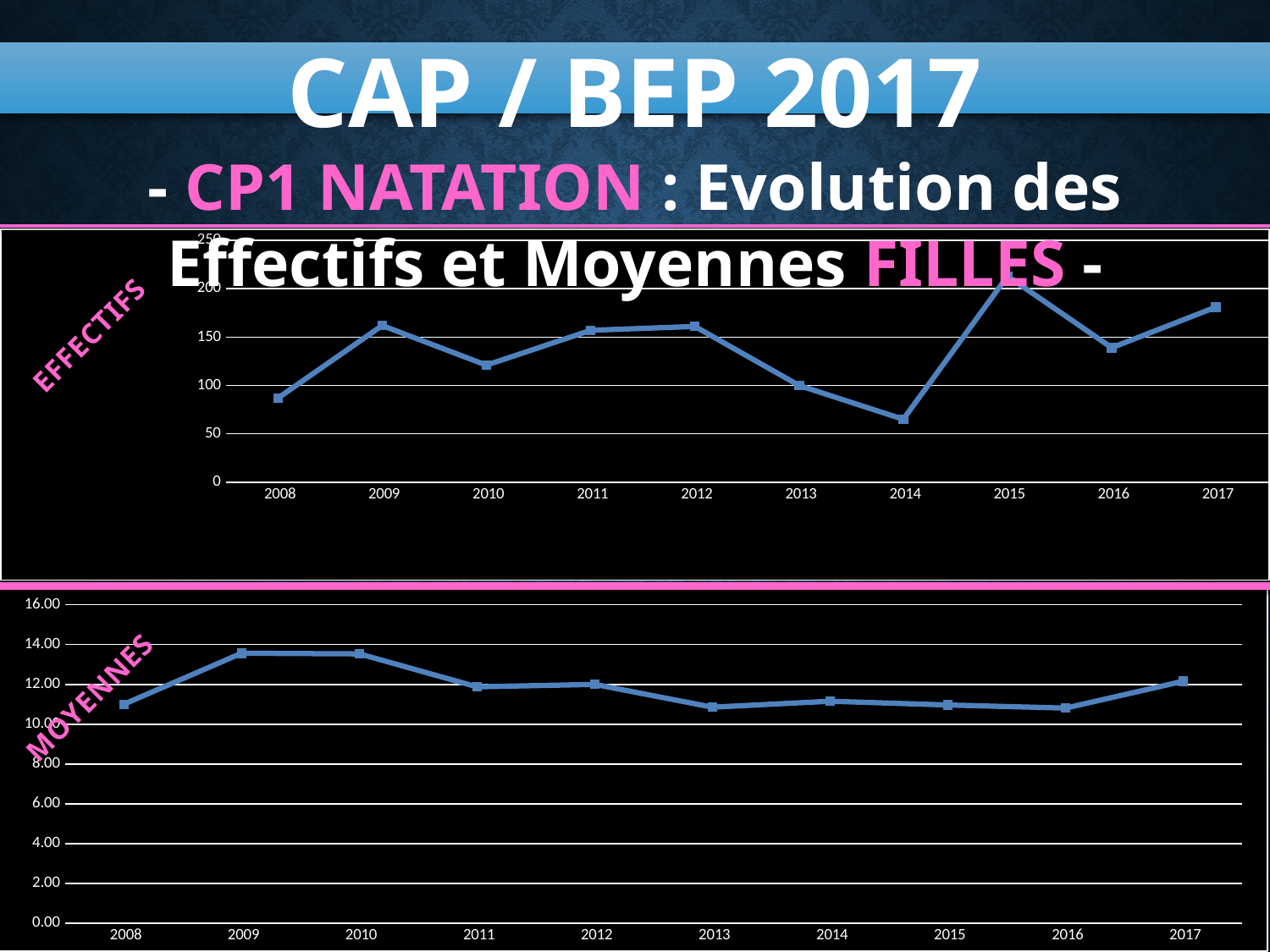
In the EFFECTIFS chart, does the value rise or fall from 2015 to 2016? fall In the EFFECTIFS chart, which year has the highest value? 2015 In the EFFECTIFS chart, which year has the lowest value? 2014 What kind of chart is the top chart labelled EFFECTIFS? line chart In the EFFECTIFS chart, is the value for 2014 greater or less than 100? less In the EFFECTIFS chart, which is larger, the value for 2009 or the value for 2010? 2009 In the MOYENNES chart, is the value for 2009 greater or less than 12.00? greater In the MOYENNES chart, does the value rise or fall from 2016 to 2017? rise What kind of chart is the bottom chart labelled MOYENNES? line chart In the EFFECTIFS chart, is the value for 2017 greater or less than 150? greater How many years are plotted on the x axis of the EFFECTIFS chart? 10 In the MOYENNES chart, which is larger, the value for 2010 or the value for 2013? 2010